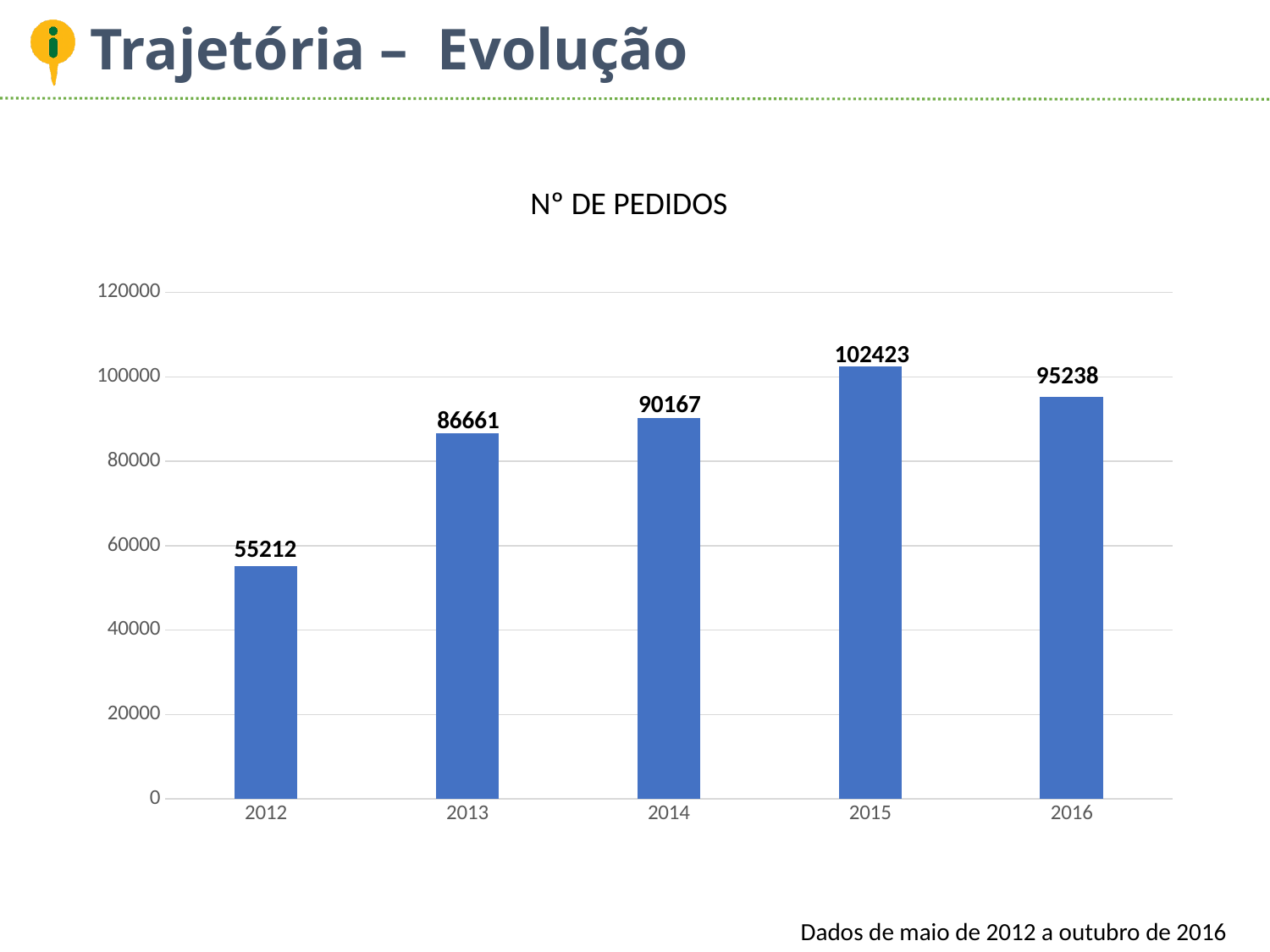
Which year has the lowest number of pedidos? 2012 What is the value for 2015? 102423 What is the difference between the values for 2015 and 2016? 7185 Which is larger, the value for 2014 or the value for 2013? 2014 What kind of chart is shown on the slide? bar chart What is the title of the chart? N° DE PEDIDOS What is the value for 2012? 55212 Which year has the highest number of pedidos? 2015 What is the difference between the values for 2013 and 2012? 31449 Is the value for 2015 greater or less than 100000? greater What is the value for 2016? 95238 How many years are shown on the x axis? 5